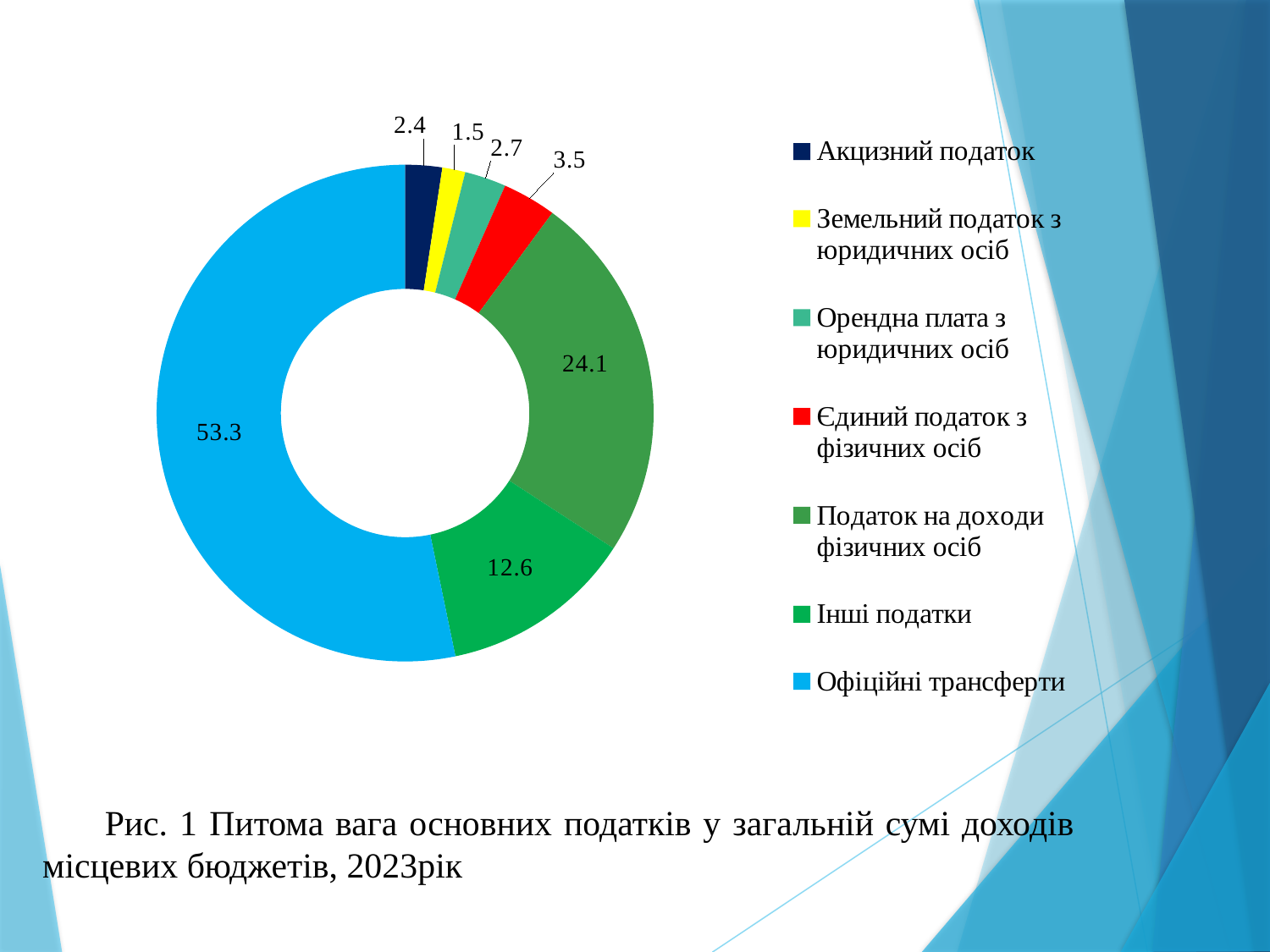
What is the difference between the values for Податок на доходи фізичних осіб and Інші податки? 11.5 What value is shown for Земельний податок з юридичних осіб? 1.5 Which is larger, the value for Орендна плата з юридичних осіб or the value for Акцизний податок? Орендна плата з юридичних осіб What value is shown for Офіційні трансферти? 53.3 What kind of chart is shown on the slide? Doughnut (pie) chart Which category has the smallest share of the chart? Земельний податок з юридичних осіб What value is shown for Інші податки? 12.6 What value is shown for Єдиний податок з фізичних осіб? 3.5 What value is shown for Податок на доходи фізичних осіб? 24.1 Which category is shown in red in the legend? Єдиний податок з фізичних осіб Which category has the largest share of the chart? Офіційні трансферти How many categories does the chart show? 7